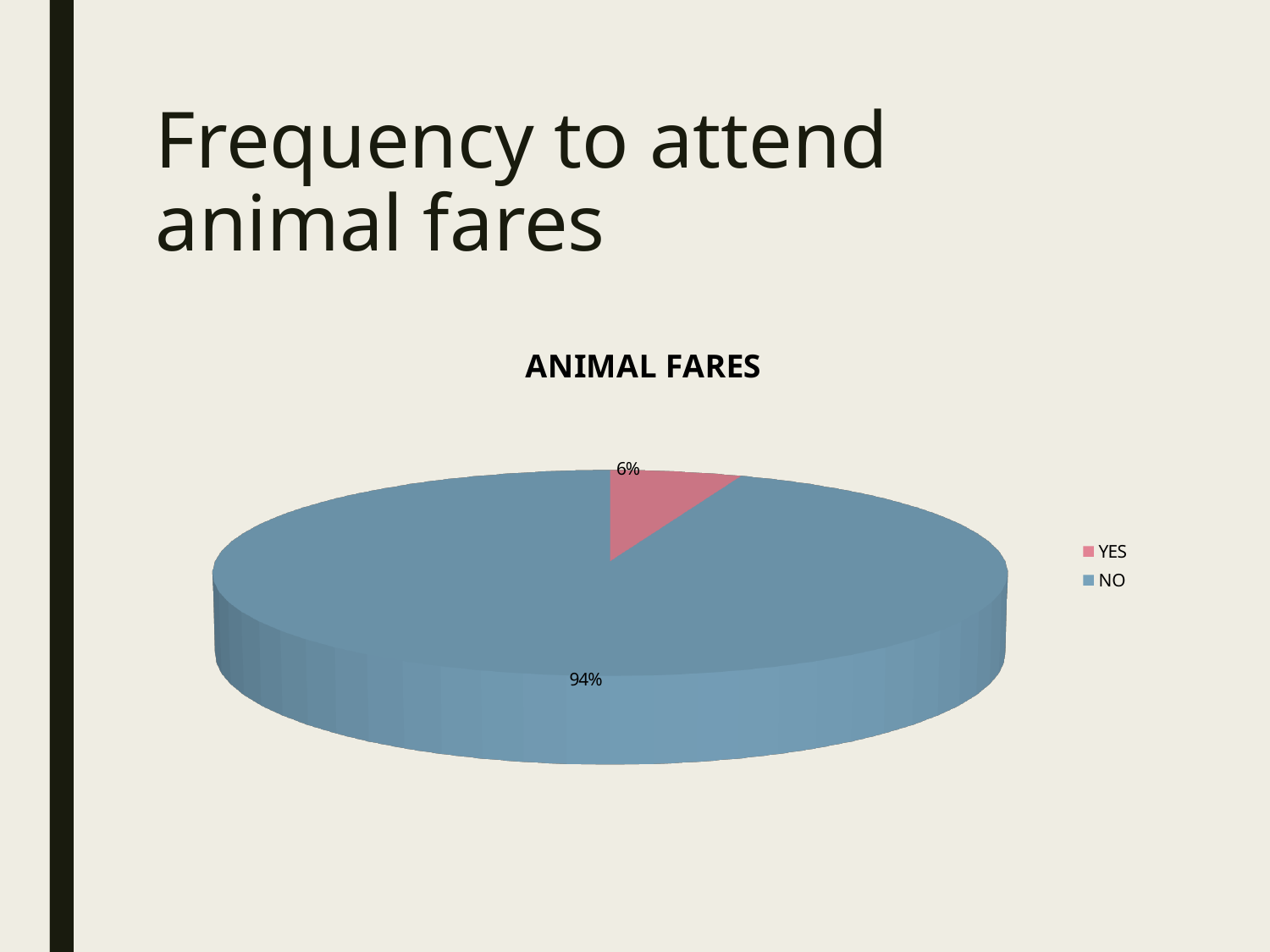
What percentage of the pie chart is labelled YES? 6% What kind of chart is shown on the slide? Pie chart What is the title of the chart? ANIMAL FARES How many slices does the pie chart have? 2 Which slice is larger, YES or NO? NO What is the difference in percentage points between the NO and YES slices? 88 How many entries does the legend list? 2 Which category has the smallest share of the pie? YES What share of the pie does the YES slice represent? 6% What colour is the NO slice in the pie chart? Blue What percentage of the pie chart is labelled NO? 94% Which category has the largest share of the pie? NO